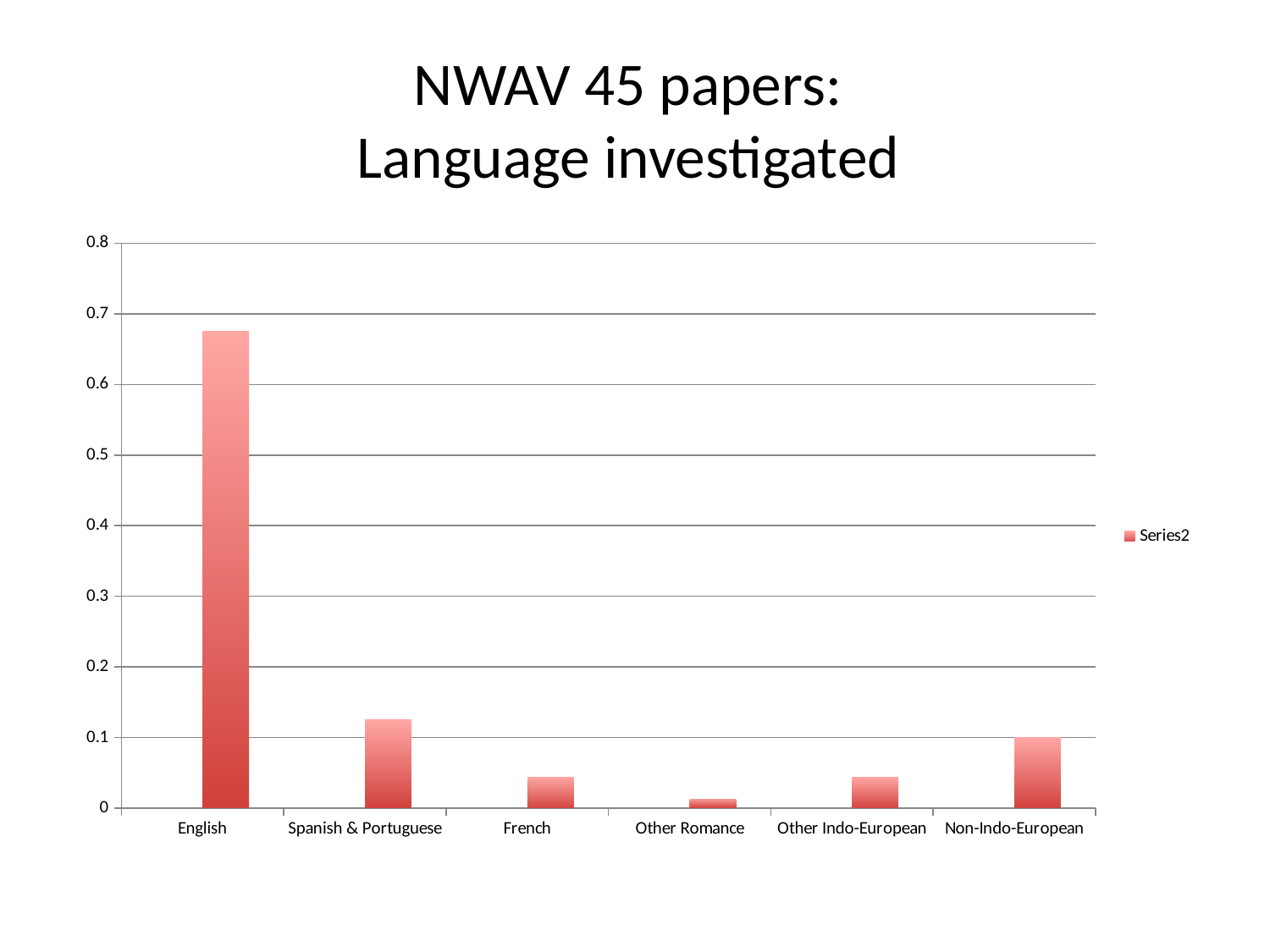
What kind of chart is shown on the slide? bar chart How many series does the legend list? 1 Which is larger, the value for Non-Indo-European or the value for French? Non-Indo-European Is the value for Spanish & Portuguese greater or less than 0.1? greater Which language category has the highest bar? English Is the value for French greater or less than 0.1? less Is the value for Other Romance greater or less than 0.1? less What is the name of the series shown in the legend? Series2 Which language category has the lowest bar? Other Romance Which is larger, the value for Spanish & Portuguese or the value for Non-Indo-European? Spanish & Portuguese How many language categories are shown on the x axis? 6